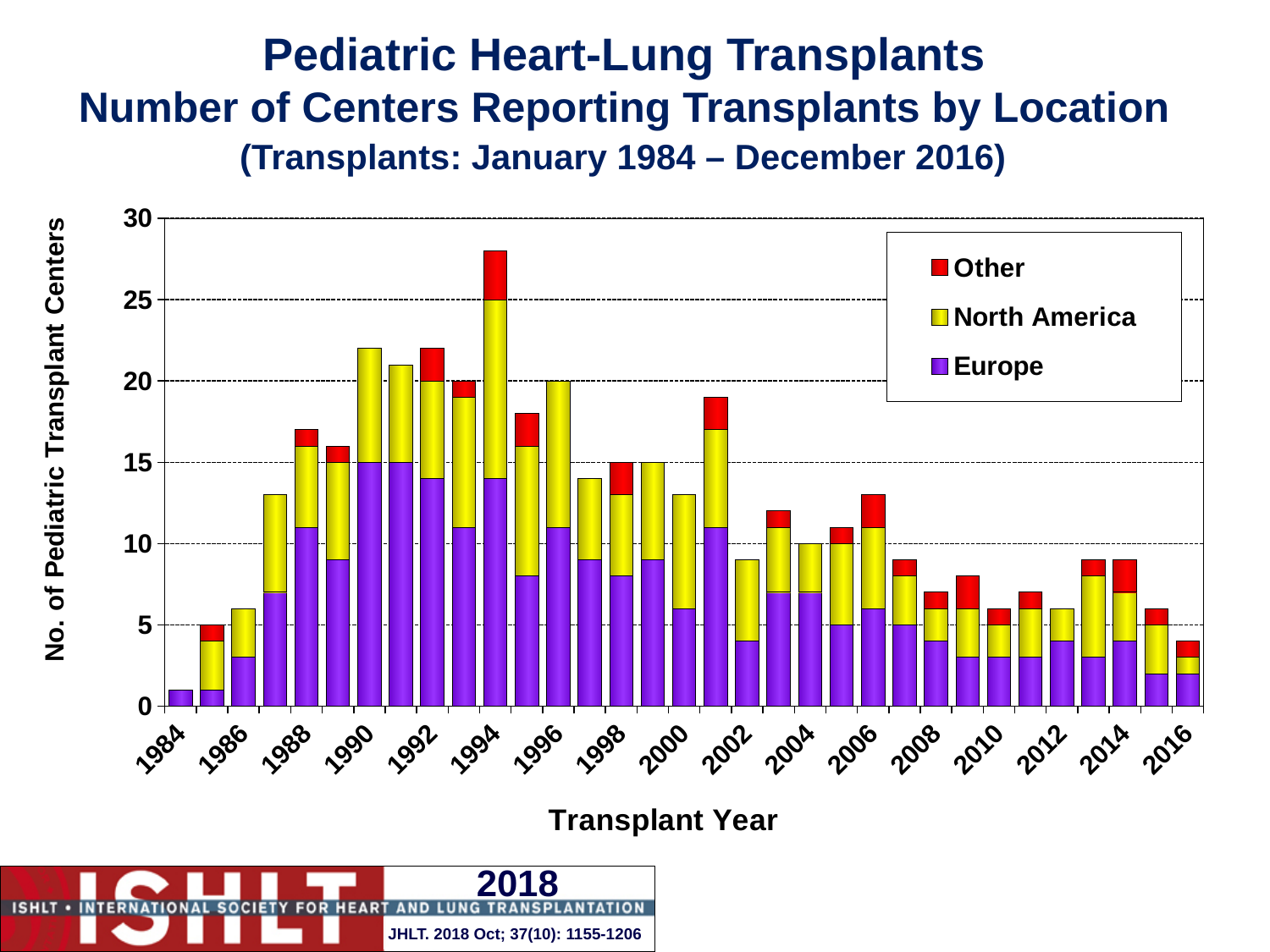
Is the total number of centers for 1994 greater or less than 25? greater Is the total number of centers for 2016 greater or less than 5? less What kind of chart is shown on the slide? Stacked bar chart Which year has a larger total number of centers, 1990 or 2010? 1990 Is the total number of centers for 1990 greater or less than 20? greater How many series does the legend list? 3 What is the label of the x axis? Transplant Year Which year has the lowest total number of pediatric transplant centers? 1984 Which colour represents Europe in the chart? Purple Which year has the highest total number of pediatric transplant centers? 1994 Do the total numbers of centers generally rise or fall from 1994 to 2016? fall